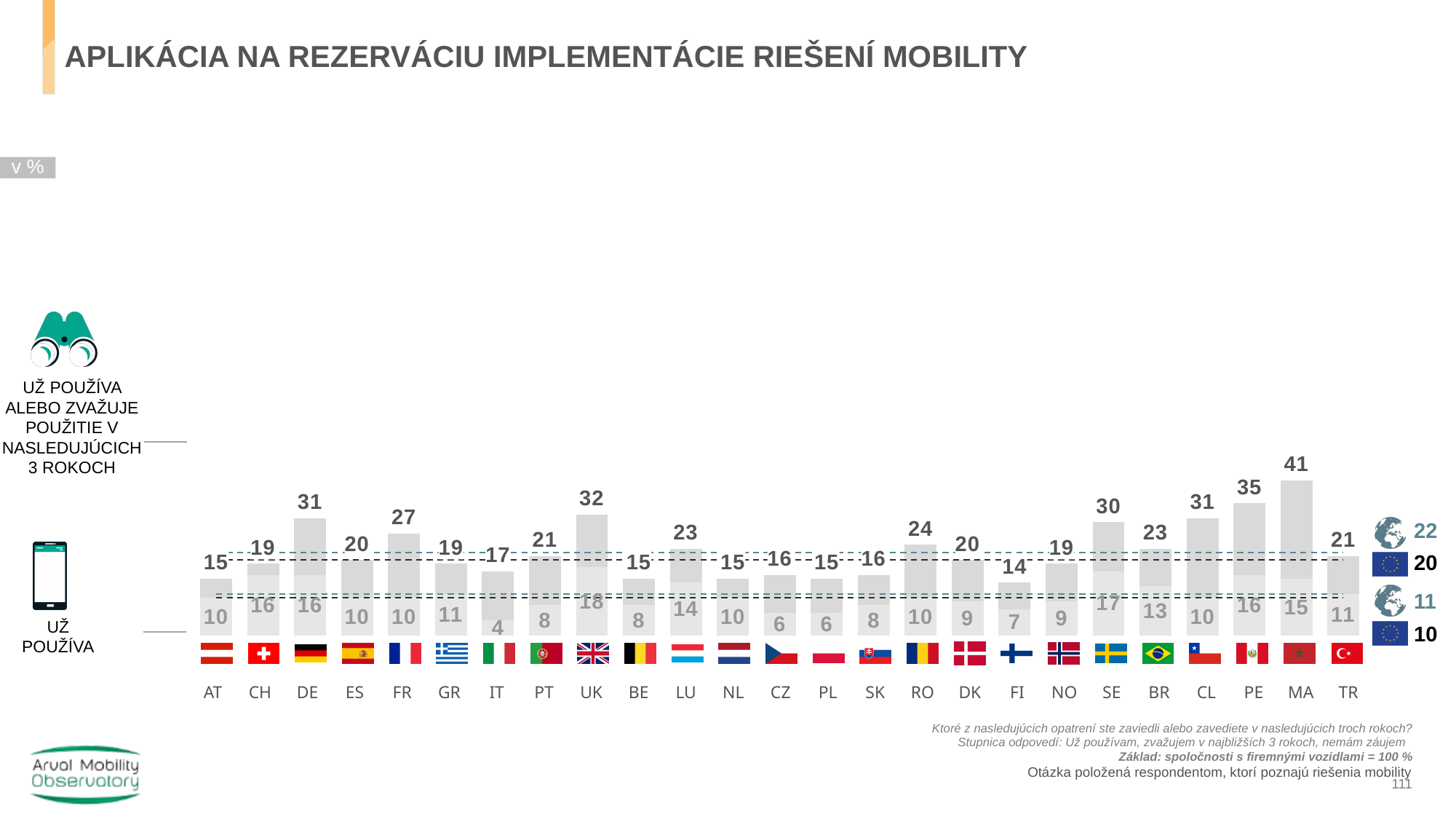
Which country has the lowest 'už používa' value? IT What is the difference between the 'už používa alebo zvažuje' value and the 'už používa' value for FR? 17 What is the 'už používa' value for UK? 18 What is the value for MA for 'už používa alebo zvažuje použitie v nasledujúcich 3 rokoch'? 41 What is the EU average value for 'už používa alebo zvažuje použitie v nasledujúcich 3 rokoch'? 20 Which country has the highest value for 'už používa alebo zvažuje použitie v nasledujúcich 3 rokoch'? MA What is the difference between the 'už používa alebo zvažuje' value for PE and for DE? 4 Which is larger, the 'už používa' value for SE or for BR? SE How many countries are shown on the x axis? 25 What kind of chart is shown on the slide? bar chart Which country has the lowest value for 'už používa alebo zvažuje použitie v nasledujúcich 3 rokoch'? FI What is the global average (globe icon) value for 'už používa'? 11